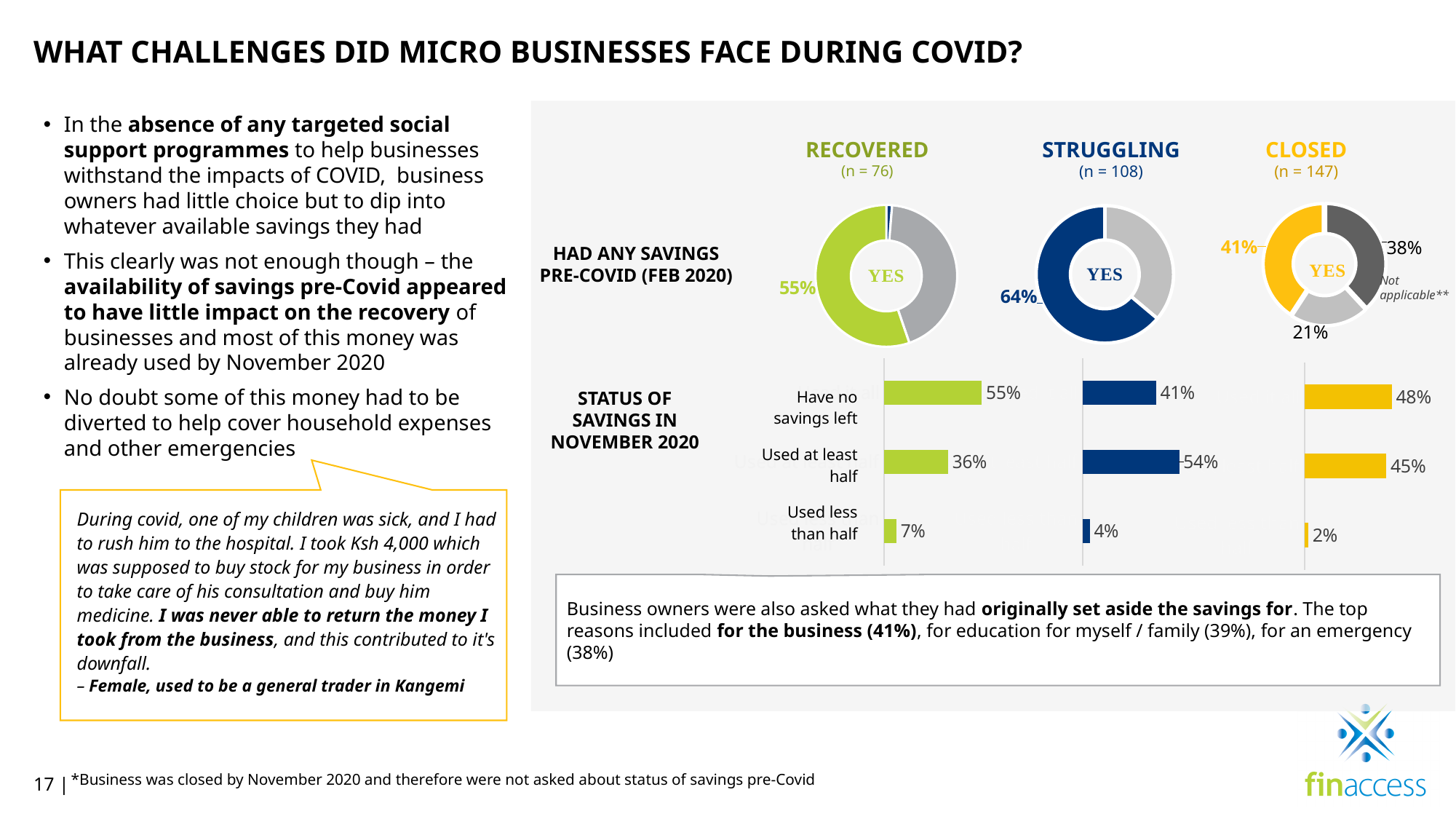
In the 'Status of savings in November 2020' bar chart, what share of Struggling businesses used at least half? 54% In the 'Had any savings pre-Covid' donut charts, which group has the highest YES share? Struggling In the 'Had any savings pre-Covid' donut charts, what share of Closed businesses answered YES? 41% In the 'Status of savings in November 2020' bar chart, what share of Recovered businesses have no savings left? 55% In the 'Status of savings in November 2020' bar chart, what is the difference between Recovered and Struggling businesses for 'Have no savings left'? 14% How many categories are shown in the 'Status of savings in November 2020' bar chart? 3 In the 'Had any savings pre-Covid' donut charts, what share of Struggling businesses answered YES? 64% In the 'Had any savings pre-Covid' donut chart for Closed businesses, what share is labelled 'Not applicable'? 38% In the 'Had any savings pre-Covid' donut charts, what share of Recovered businesses answered YES? 55% In the 'Status of savings in November 2020' bar chart, what share of Closed businesses used less than half? 2% In the 'Status of savings in November 2020' bar chart, which is larger for Closed businesses: 'Have no savings left' or 'Used at least half'? Have no savings left In the 'Status of savings in November 2020' bar chart, which category is lowest for Struggling businesses? Used less than half